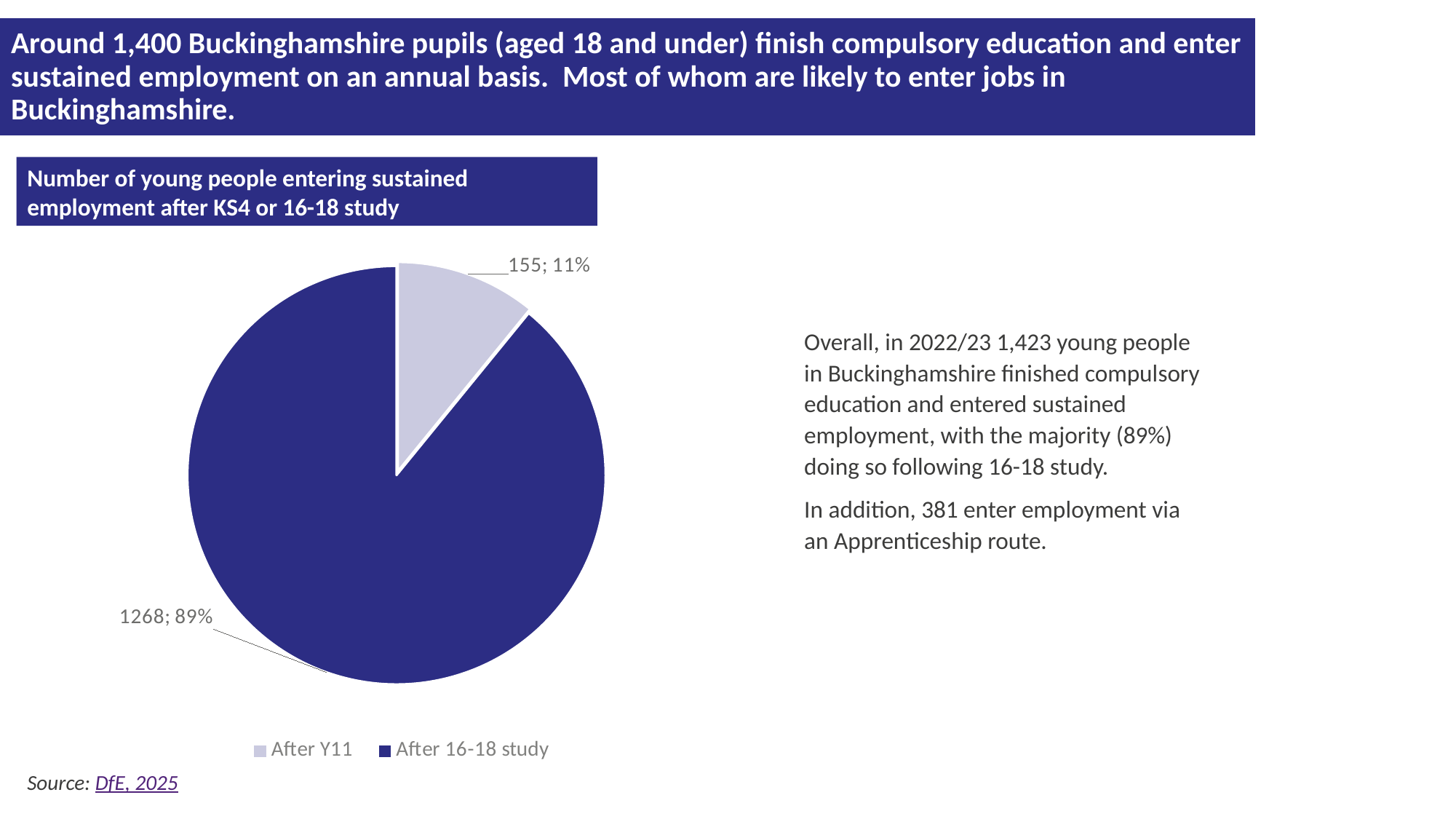
What is the difference between the number entering employment after 16-18 study and after Y11? 1113 Which category has the largest slice of the pie? After 16-18 study How many young people entered sustained employment after 16-18 study? 1268 What type of chart is shown on the slide? Pie chart How many young people entered sustained employment after Y11? 155 How many categories does the pie chart show? 2 Which category has the smallest slice of the pie? After Y11 Which is larger: the number entering employment after Y11 or after 16-18 study? After 16-18 study What share of the pie does the 'After 16-18 study' slice represent? 89% What share of the pie does the 'After Y11' slice represent? 11% What is the title of the chart? Number of young people entering sustained employment after KS4 or 16-18 study What is the total of the two slices in the pie chart? 1423